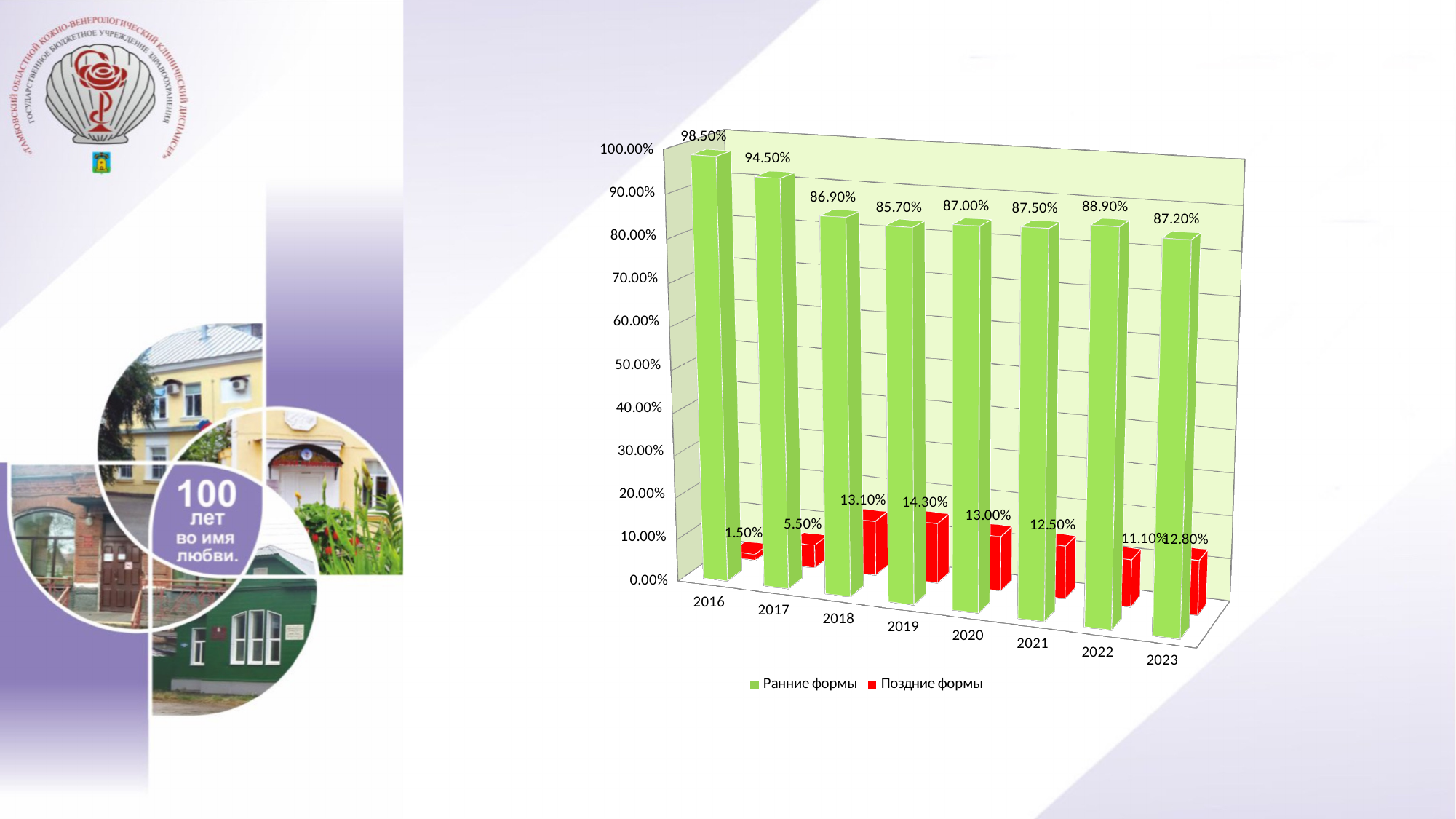
What is the value for Ранние формы in 2016? 98.50% What is the value for Ранние формы in 2023? 87.20% Which is larger: Поздние формы in 2018 or in 2021? 2018 What kind of chart is shown on the slide? Bar chart How many series does the legend list? 2 How many years are shown on the x axis? 8 In which year is Поздние формы highest? 2019 What is the value for Поздние формы in 2022? 11.10% In which year is Ранние формы highest? 2016 What is the difference between Ранние формы in 2016 and 2017? 4.00% What is the value for Поздние формы in 2019? 14.30% In which year is Поздние формы lowest? 2016